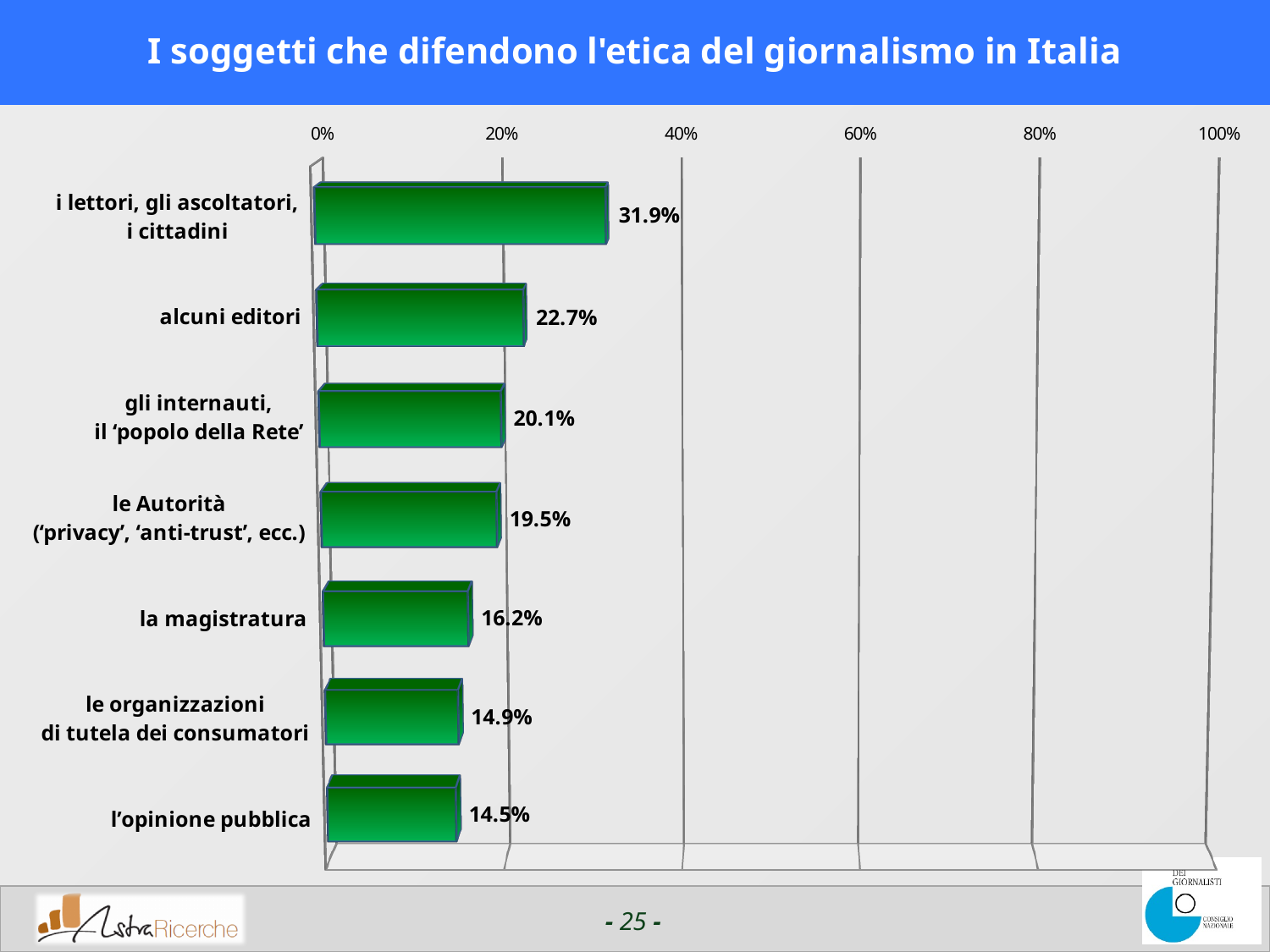
Is the value for 'le Autorità (privacy, anti-trust, ecc.)' greater or less than 20%? less What is the difference between the values for 'i lettori, gli ascoltatori, i cittadini' and 'alcuni editori'? 9.2% Which is larger, the value for 'gli internauti, il popolo della Rete' or for 'la magistratura'? gli internauti, il popolo della Rete What is the highest value shown on the percentage axis? 100% What is the title of the chart? I soggetti che difendono l'etica del giornalismo in Italia Which category has the lowest value? l'opinione pubblica How many categories are shown in the chart? 7 What is the value for 'alcuni editori'? 22.7% What is the value for 'le organizzazioni di tutela dei consumatori'? 14.9% What kind of chart is shown on the slide? bar chart Which category has the highest value? i lettori, gli ascoltatori, i cittadini What is the value for 'la magistratura'? 16.2%